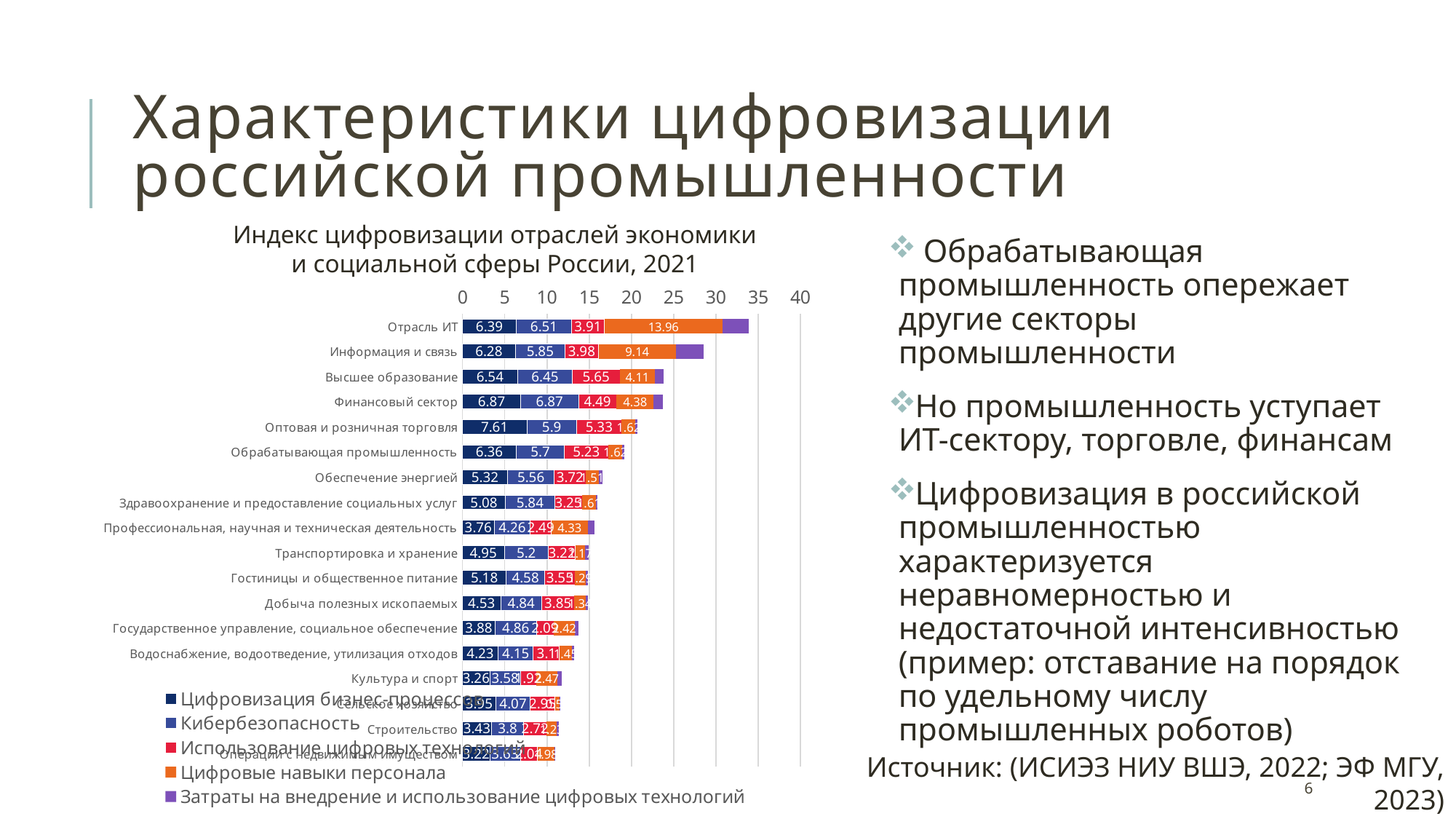
Which category has the longest total bar in the chart? Отрасль ИТ What is the difference between the Цифровизация бизнес-процессов values for Финансовый сектор and Отрасль ИТ? 0.48 What kind of chart is shown on the slide? Stacked bar chart Is the total bar length for Финансовый сектор greater or less than 20? greater What is the value of Кибербезопасность for Высшее образование? 6.45 Which category has the highest value for Цифровизация бизнес-процессов? Оптовая и розничная торговля Which has the larger value for Цифровые навыки персонала: Отрасль ИТ or Информация и связь? Отрасль ИТ What is the value of Цифровизация бизнес-процессов for Оптовая и розничная торговля? 7.61 How many series does the chart legend list? 5 What is the value of Использование цифровых технологий for Высшее образование? 5.65 What is the value of Цифровые навыки персонала for Отрасль ИТ? 13.96 How many industry categories are plotted in the chart? 18